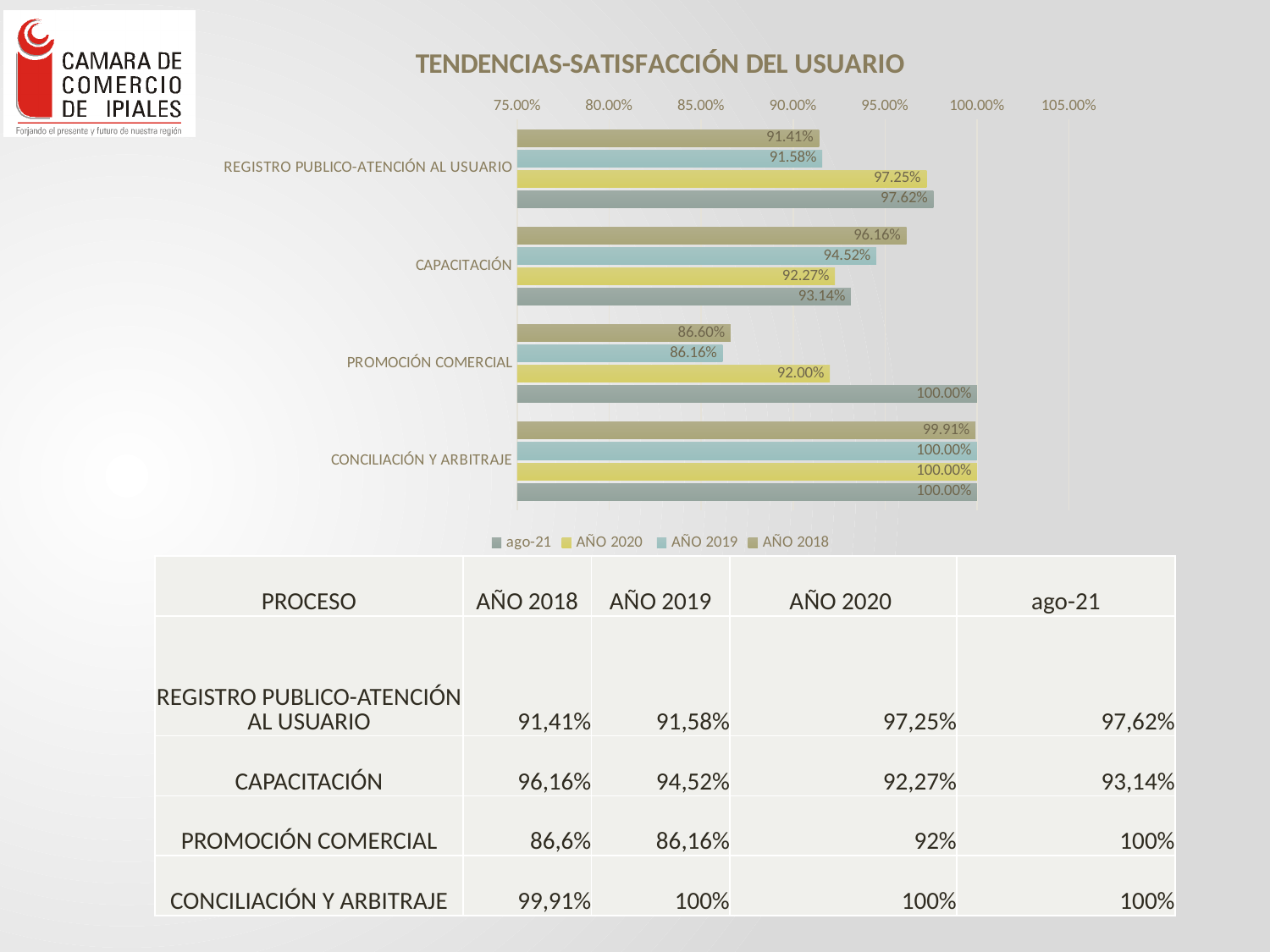
What type of chart is shown on the slide? bar chart What is the AÑO 2020 value for CAPACITACIÓN? 92.27% For CAPACITACIÓN, which is larger: the AÑO 2018 value or the ago-21 value? AÑO 2018 How many categories are shown on the chart? 4 What is the AÑO 2018 value for REGISTRO PUBLICO-ATENCIÓN AL USUARIO? 91.41% How many series does the chart legend list? 4 What is the difference between the ago-21 and AÑO 2018 values for PROMOCIÓN COMERCIAL? 13.40% What is the AÑO 2018 value for CONCILIACIÓN Y ARBITRAJE? 99.91% Which category has the lowest AÑO 2018 value? PROMOCIÓN COMERCIAL Which category has the highest AÑO 2020 value? CONCILIACIÓN Y ARBITRAJE What is the AÑO 2019 value for PROMOCIÓN COMERCIAL? 86.16% What is the title of the chart? TENDENCIAS-SATISFACCIÓN DEL USUARIO